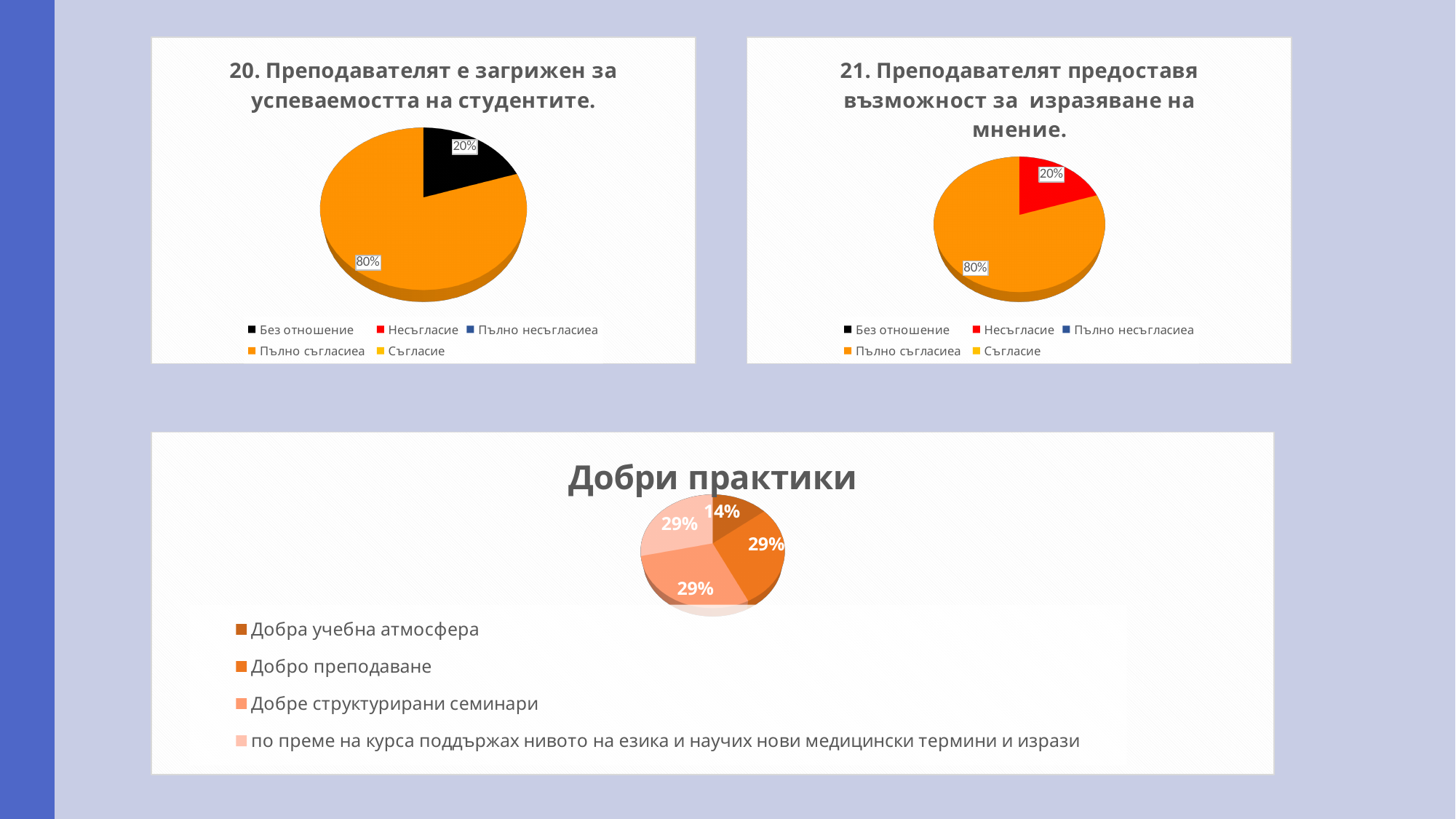
In the chart titled "20. Преподавателят е загрижен за успеваемостта на студентите.", what share does "Пълно съгласиеа" have? 80% In the chart titled "21. Преподавателят предоставя възможност за изразяване на мнение.", what share does "Несъгласие" have? 20% In the chart titled "Добри практики", what share does "Добро преподаване" have? 29% In the chart titled "Добри практики", how many categories does the legend list? 4 In the chart titled "21. Преподавателят предоставя възможност за изразяване на мнение.", which category has the largest slice? Пълно съгласиеа In the chart titled "20. Преподавателят е загрижен за успеваемостта на студентите.", what is the difference between the "Пълно съгласиеа" and "Без отношение" shares? 60% In the chart titled "20. Преподавателят е загрижен за успеваемостта на студентите.", what share does "Без отношение" have? 20% What type of chart is the chart titled "Добри практики"? Pie chart In the chart titled "Добри практики", which is larger: the share for "Добро преподаване" or the share for "Добра учебна атмосфера"? Добро преподаване In the chart titled "Добри практики", what share does "Добра учебна атмосфера" have? 14% In the chart titled "21. Преподавателят предоставя възможност за изразяване на мнение.", how many entries does the legend list? 5 In the chart titled "Добри практики", which category has the smallest slice? Добра учебна атмосфера